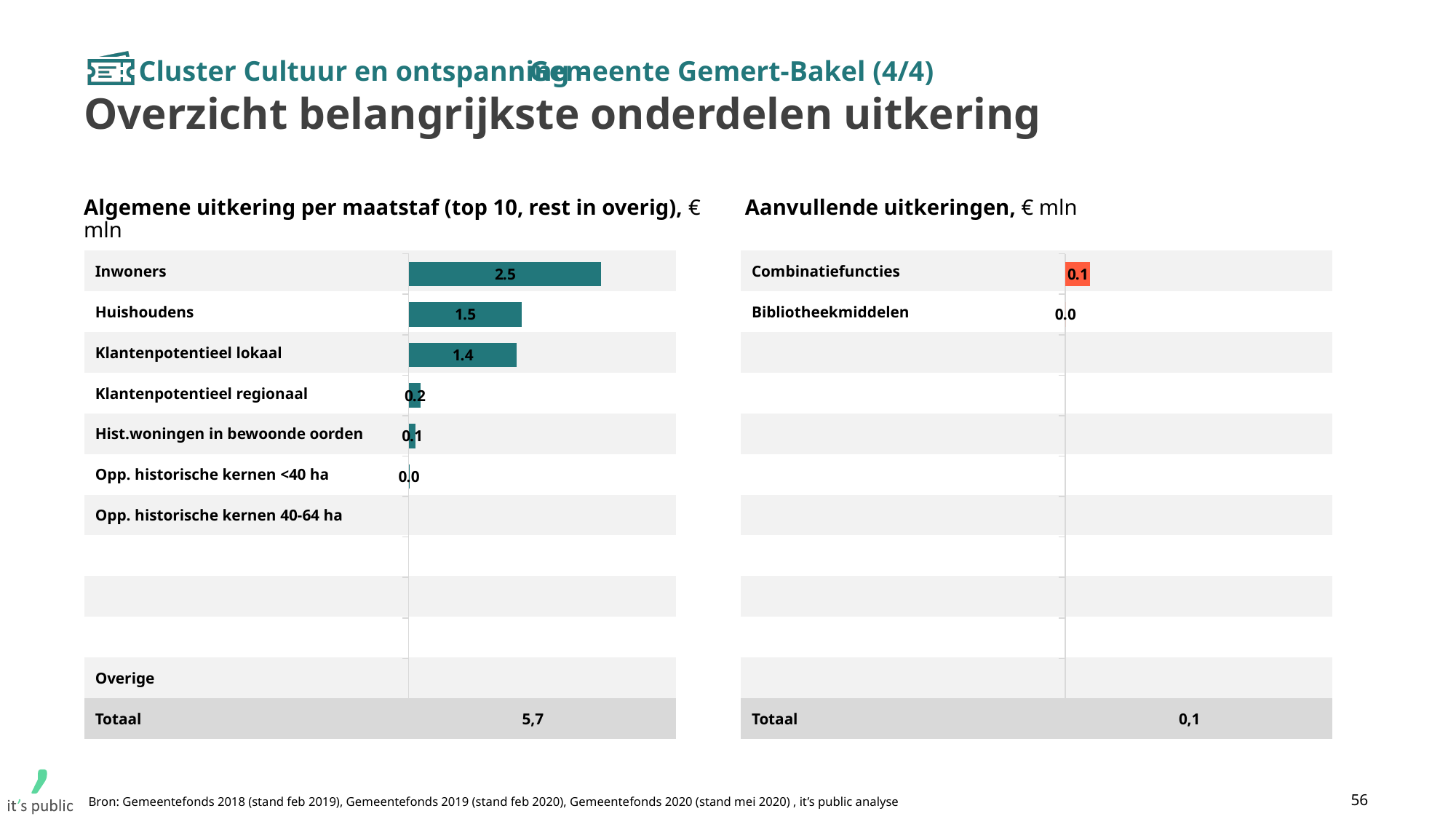
On the chart 'Algemene uitkering per maatstaf', which is larger: Huishoudens or Klantenpotentieel lokaal? Huishoudens What kind of chart is 'Algemene uitkering per maatstaf'? Bar chart On the chart 'Algemene uitkering per maatstaf', what is the Totaal shown? 5,7 On the chart 'Aanvullende uitkeringen', what is the value for Combinatiefuncties? 0.1 On the chart 'Algemene uitkering per maatstaf', what is the value for Klantenpotentieel lokaal? 1.4 On the chart 'Aanvullende uitkeringen', which category has the lowest value? Bibliotheekmiddelen On the chart 'Algemene uitkering per maatstaf', what is the value for Klantenpotentieel regionaal? 0.2 On the chart 'Algemene uitkering per maatstaf', what is the value for Inwoners? 2.5 What unit is stated in the title of the chart 'Aanvullende uitkeringen'? € mln On the chart 'Algemene uitkering per maatstaf', what is the difference between Inwoners and Huishoudens? 1.0 On the chart 'Aanvullende uitkeringen', how many categories are labeled? 2 On the chart 'Algemene uitkering per maatstaf', which category has the highest value? Inwoners